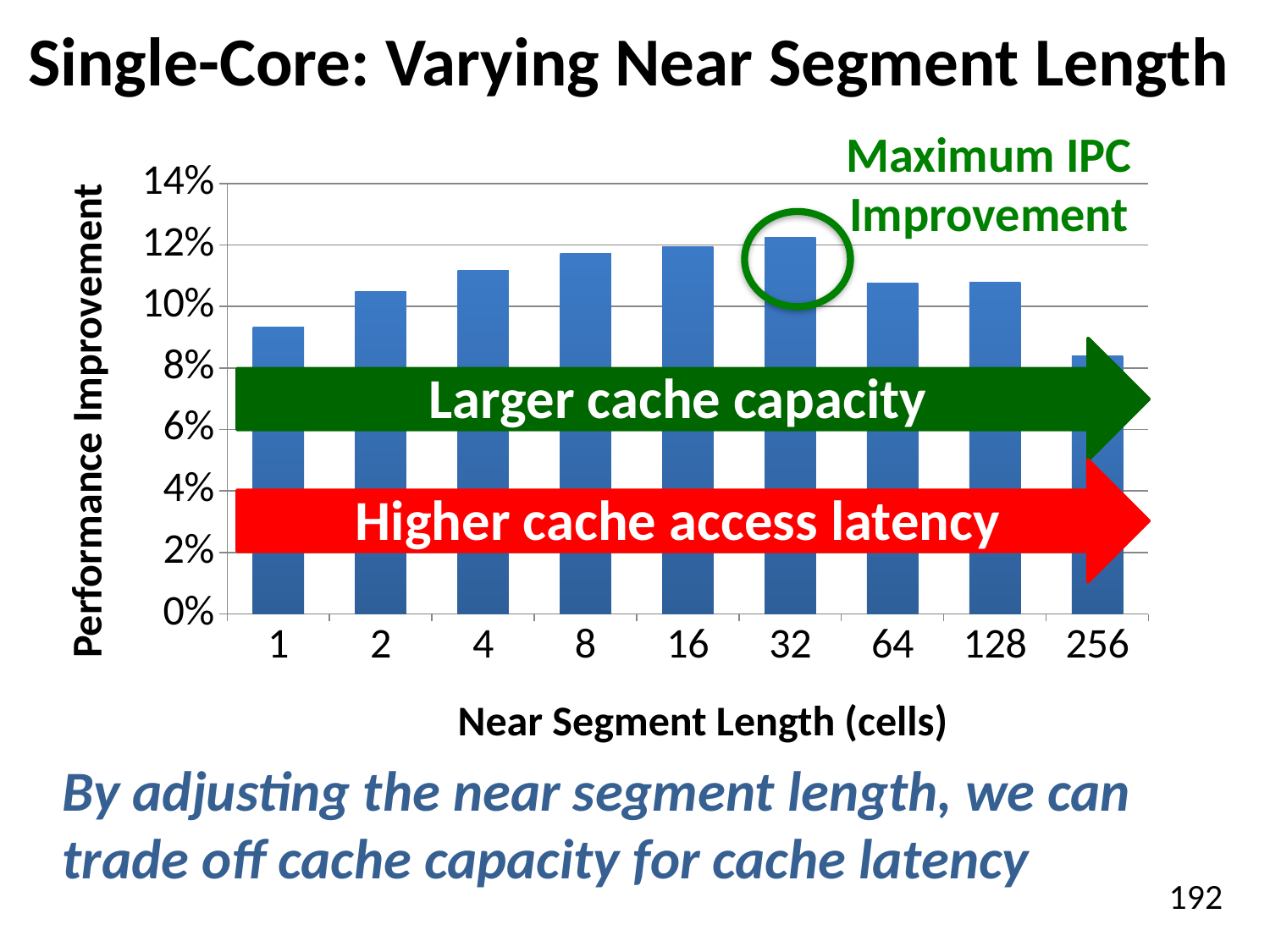
Is the performance improvement for a near segment length of 1 greater or less than 8%? greater Which has the larger performance improvement: near segment length 1 or 256? 1 How does performance improvement change as near segment length increases from 1 to 256? rises up to 32, then falls Is the performance improvement for a near segment length of 256 greater or less than 10%? less What is the label of the x axis? Near Segment Length (cells) What kind of chart is shown on the slide? bar chart How many near segment length categories are plotted on the x axis? 9 Which has the larger performance improvement: near segment length 2 or 8? 8 Is the performance improvement for a near segment length of 2 greater or less than 10%? greater Which near segment length gives the highest performance improvement? 32 Which near segment length gives the lowest performance improvement? 256